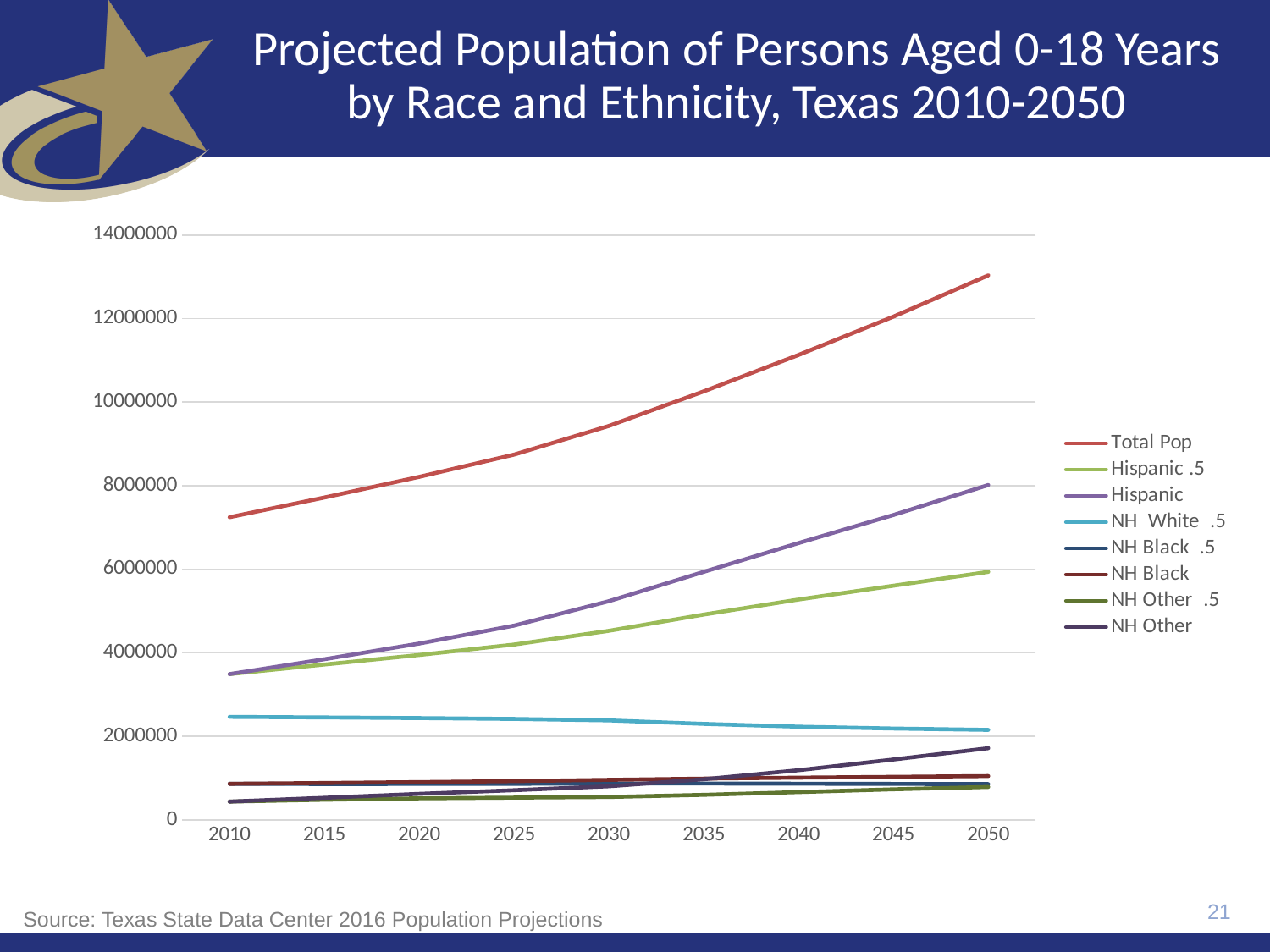
Does the NH White .5 line rise or fall from 2010 to 2050? fall Is the Hispanic value in 2050 greater or less than 6000000? greater What is the title of the chart on the slide? Projected Population of Persons Aged 0-18 Years by Race and Ethnicity, Texas 2010-2050 What kind of chart is shown on the slide? line chart Is the Total Pop value in 2050 greater or less than 12000000? greater Which series has the highest value in 2050? Total Pop In 2050, which is larger: Hispanic or Hispanic .5? Hispanic How many years are marked along the x axis? 9 Does the Total Pop line rise or fall from 2010 to 2050? rise Is the Total Pop value in 2010 greater or less than 8000000? less How many series does the legend list? 8